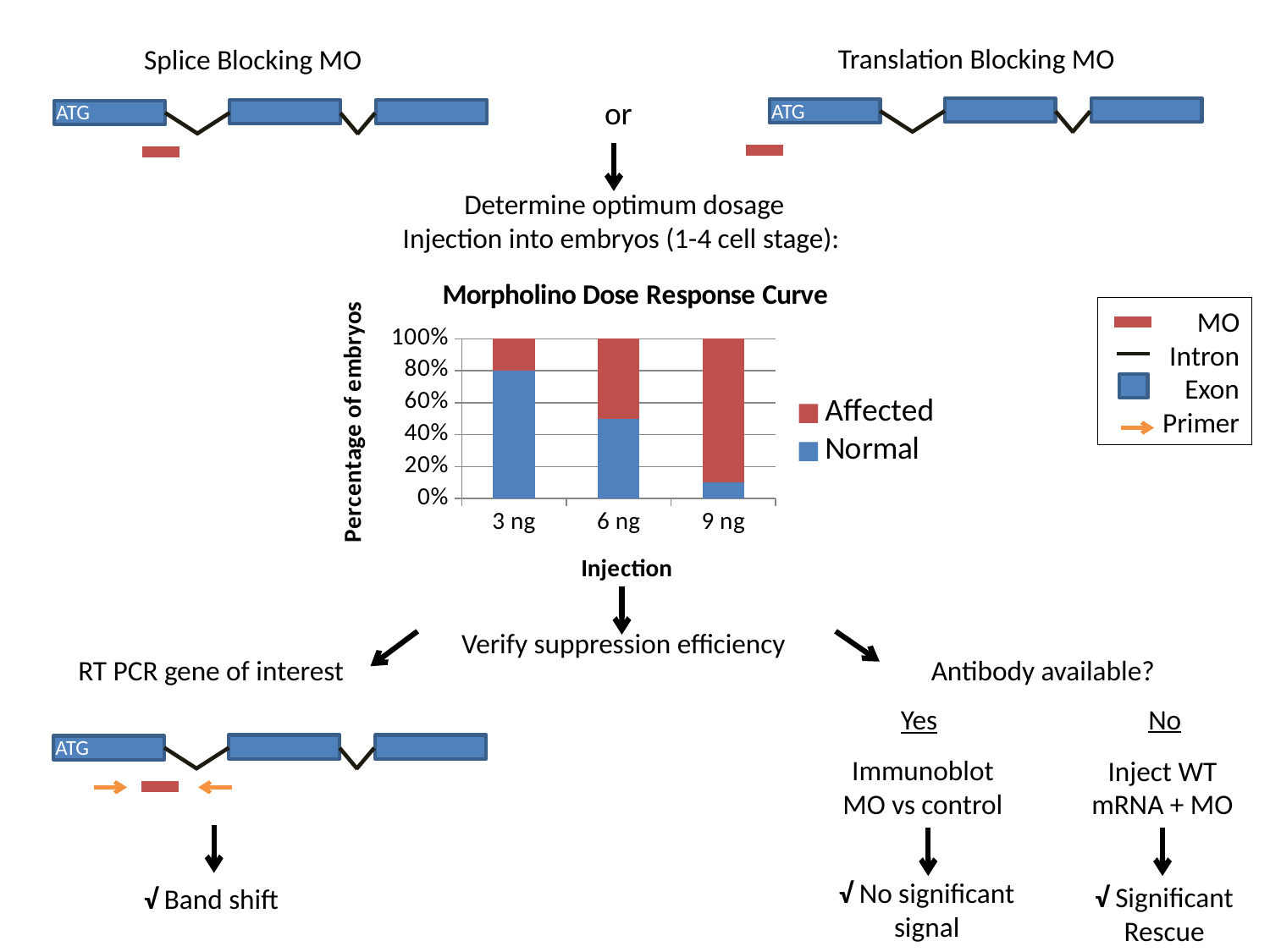
How many dosage categories are shown on the x axis of the Morpholino Dose Response Curve? 3 Is the Normal value for 9 ng greater or less than 20%? less What percentage of embryos were Normal at the 3 ng injection? 80% What type of chart is the Morpholino Dose Response Curve? Stacked bar chart What is the x-axis title of the Morpholino Dose Response Curve? Injection Which injection dose has the highest percentage of Affected embryos? 9 ng Is the Normal value for 6 ng greater or less than 40%? greater Is the Affected value for 9 ng greater or less than 80%? greater How many series does the legend of the Morpholino Dose Response Curve list? 2 Which injection dose has the highest percentage of Normal embryos? 3 ng What percentage of embryos were Affected at the 3 ng injection? 20% How does the Normal percentage change as the injection dose increases from 3 ng to 9 ng? It falls